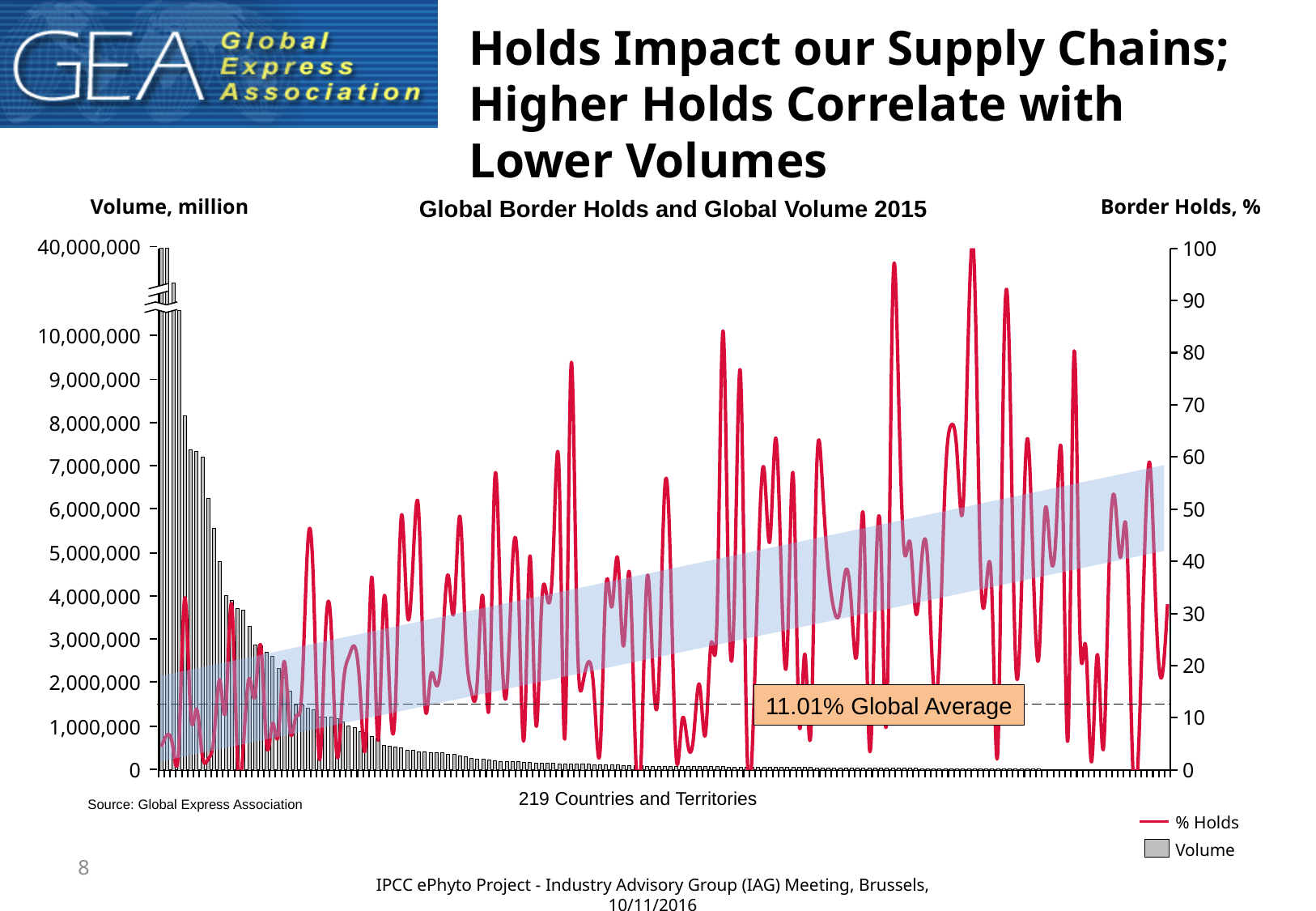
What is the label of the left vertical axis? Volume, million What global average value for border holds is annotated on the chart? 11.01% What is the title of the chart? Global Border Holds and Global Volume 2015 What are the two series named in the chart legend? % Holds and Volume Do the Volume bars rise or fall from left to right along the x axis? Fall What is the highest value shown on the left-hand Volume axis? 40,000,000 Does the shaded trend band for % Holds rise or fall from left to right along the x axis? Rise What kind of chart is used to show the Volume series? Bar chart How many countries and territories does the x axis say are plotted? 219 What is the highest value shown on the right-hand Border Holds axis? 100 What kind of chart is used to show the % Holds series? Line chart How many series does the chart legend list? 2